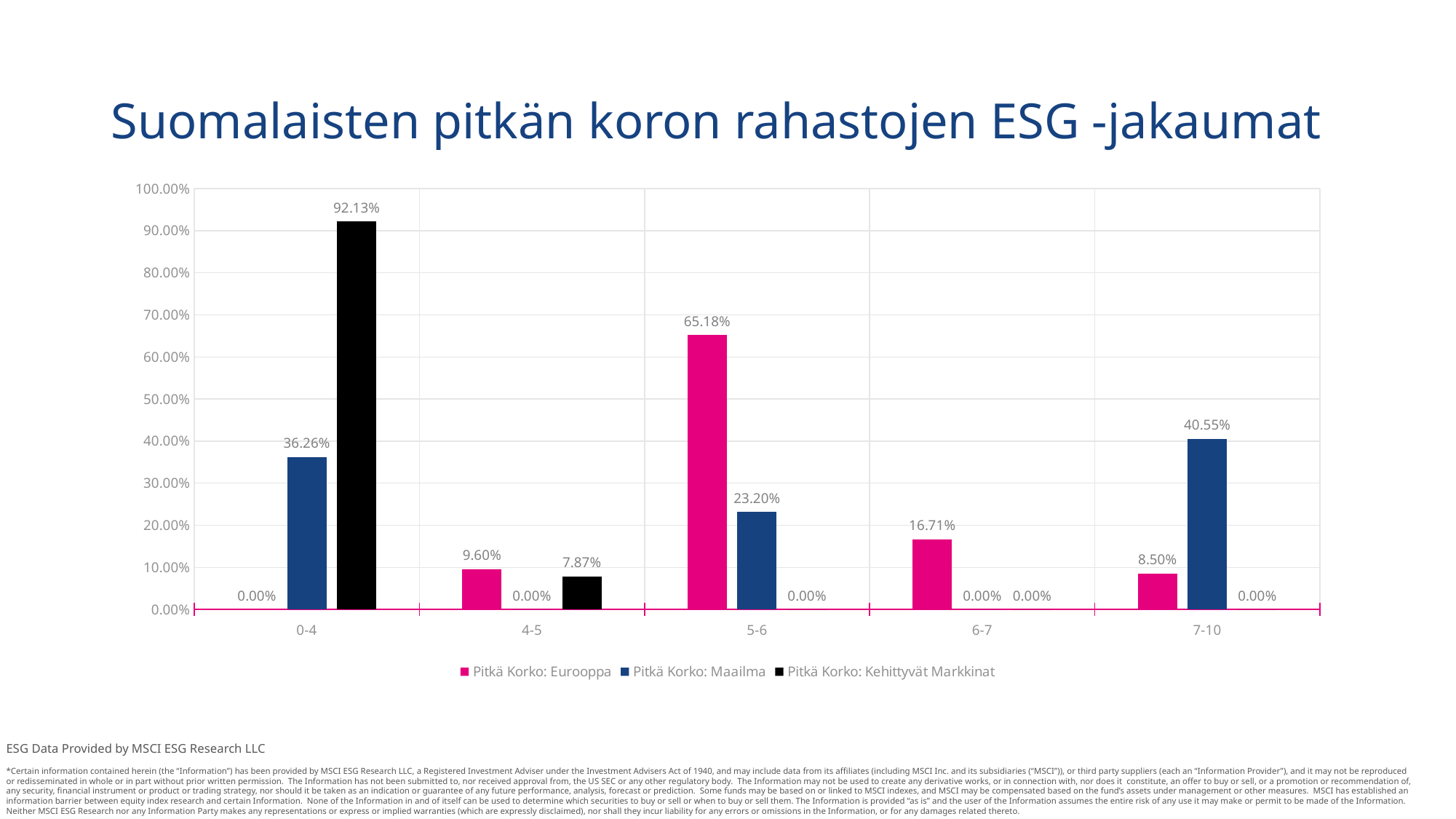
Which category has the lowest non-zero value for Pitkä Korko: Eurooppa? 7-10 How many categories are shown on the x axis? 5 Which is larger in the 4-5 category: Pitkä Korko: Eurooppa or Pitkä Korko: Kehittyvät Markkinat? Pitkä Korko: Eurooppa Which category has the highest value for Pitkä Korko: Maailma? 7-10 How many series does the legend list? 3 What is the value for Pitkä Korko: Eurooppa in the 6-7 category? 16.71% What is the difference between Pitkä Korko: Eurooppa and Pitkä Korko: Maailma in the 5-6 category? 41.98% What is the value for Pitkä Korko: Kehittyvät Markkinat in the 0-4 category? 92.13% What is the value for Pitkä Korko: Maailma in the 7-10 category? 40.55% What is the title of the slide? Suomalaisten pitkän koron rahastojen ESG -jakaumat What is the value for Pitkä Korko: Eurooppa in the 5-6 category? 65.18% What kind of chart is shown on the slide? Bar chart